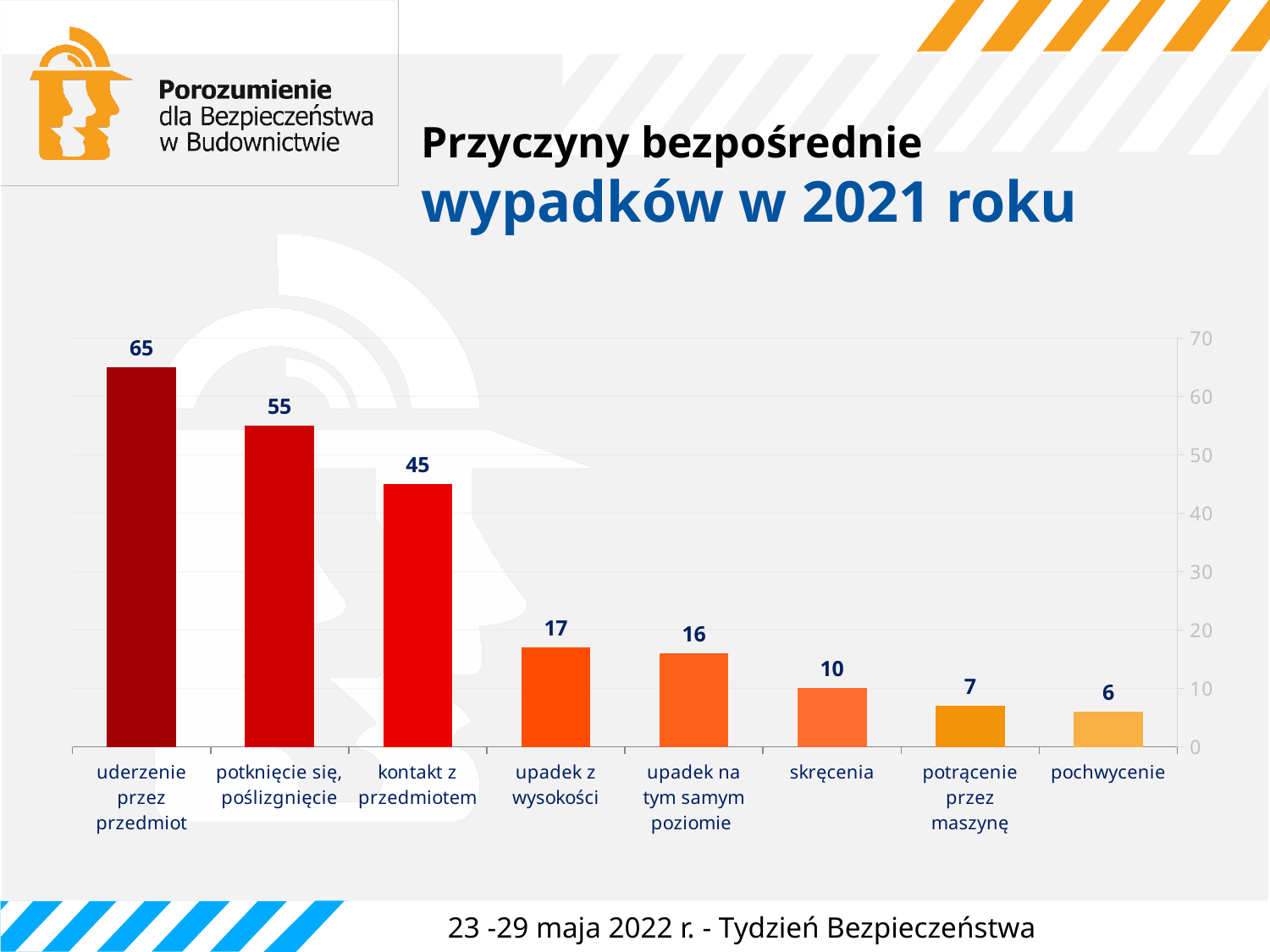
What is the difference between "potknięcie się, poślizgnięcie" and "kontakt z przedmiotem"? 10 Which is larger: "skręcenia" or "upadek na tym samym poziomie"? upadek na tym samym poziomie What is the value for "uderzenie przez przedmiot"? 65 What is the title of the chart on the slide? Przyczyny bezpośrednie wypadków w 2021 roku Which category has the lowest value? pochwycenie What is the value for "potrącenie przez maszynę"? 7 Which category has the highest value? uderzenie przez przedmiot Is the value for "kontakt z przedmiotem" greater or less than 40? greater What kind of chart is shown on the slide? bar chart How many categories are shown in the chart? 8 Do the values rise or fall from left to right along the x axis? fall What is the value for "upadek z wysokości"? 17